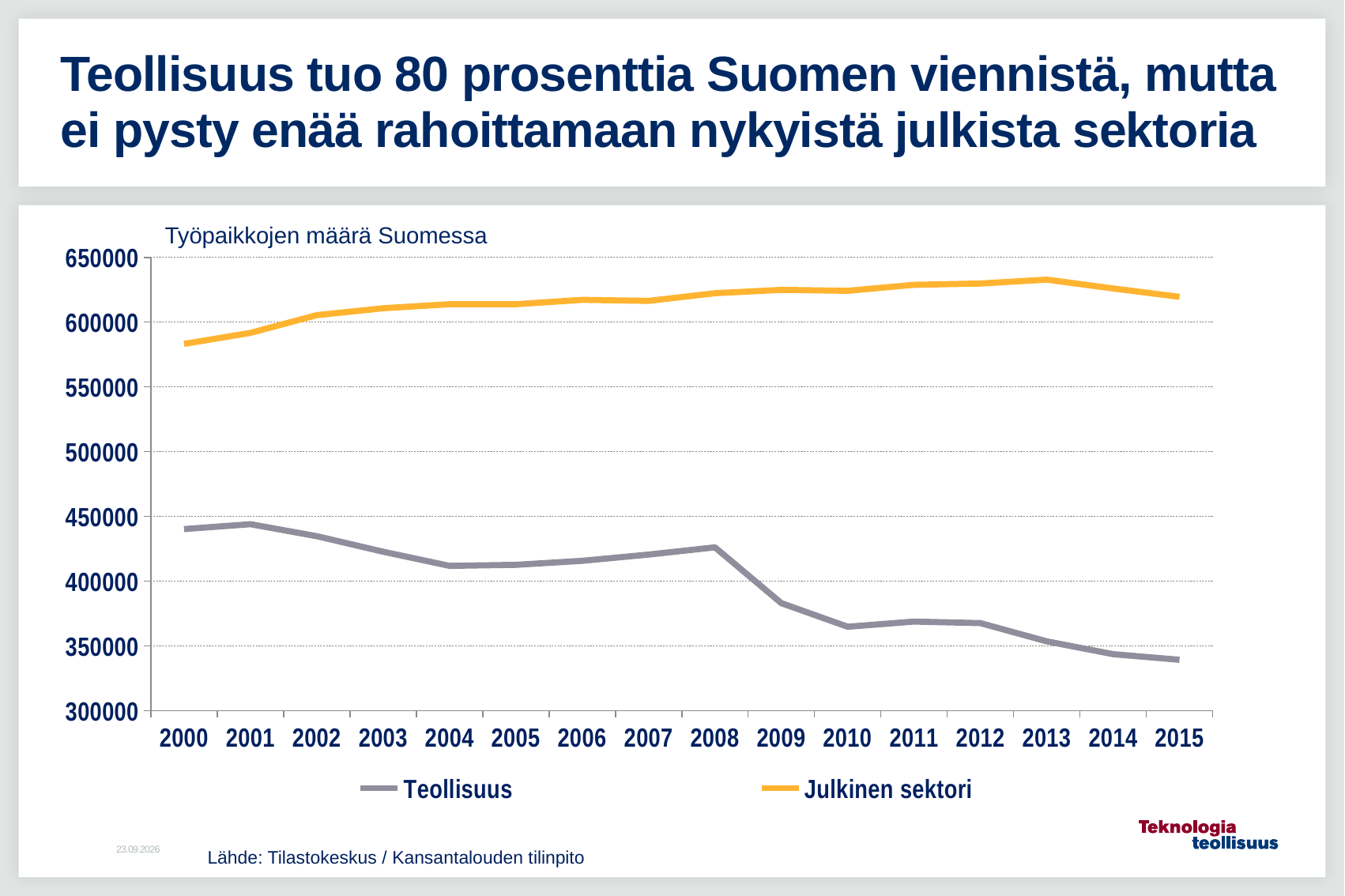
How many years are shown on the x axis? 16 What is the title printed above the chart? Työpaikkojen määrä Suomessa Which series is plotted in yellow? Julkinen sektori Is the value for Teollisuus in 2015 greater or less than 350000? less Is the value for Teollisuus in 2008 greater or less than 400000? greater Does the Teollisuus line rise or fall overall from 2000 to 2015? fall Does the Julkinen sektori line rise or fall from 2000 to 2013? rise Is the value for Julkinen sektori in 2000 greater or less than 600000? less What kind of chart is shown on the slide? line chart In which year is the Julkinen sektori value lowest? 2000 How many series does the legend list? 2 Which is larger for Teollisuus, the value in 2008 or the value in 2009? 2008